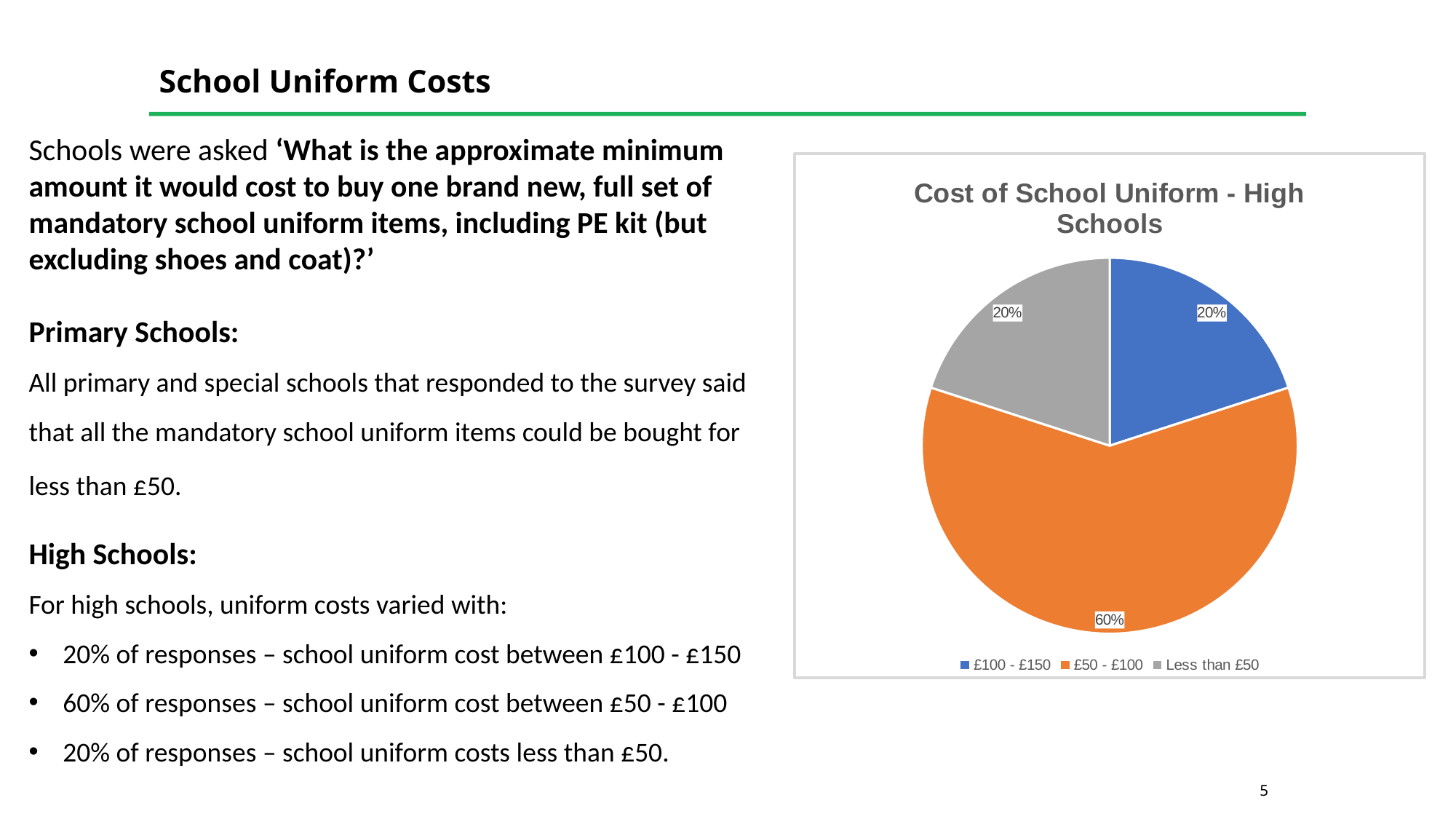
What share of the pie is the £100 - £150 slice? 20% Which category has the largest slice of the pie? £50 - £100 Which is larger, the £50 - £100 slice or the Less than £50 slice? £50 - £100 What kind of chart is shown on the slide? pie chart What share of the pie is the Less than £50 slice? 20% What is the combined share of the £100 - £150 and Less than £50 slices? 40% How many categories does the legend list? 3 What colour is the £50 - £100 slice? orange What share of the pie is the £50 - £100 slice? 60% What is the difference between the £50 - £100 share and the £100 - £150 share? 40% What is the title of the chart? Cost of School Uniform - High Schools